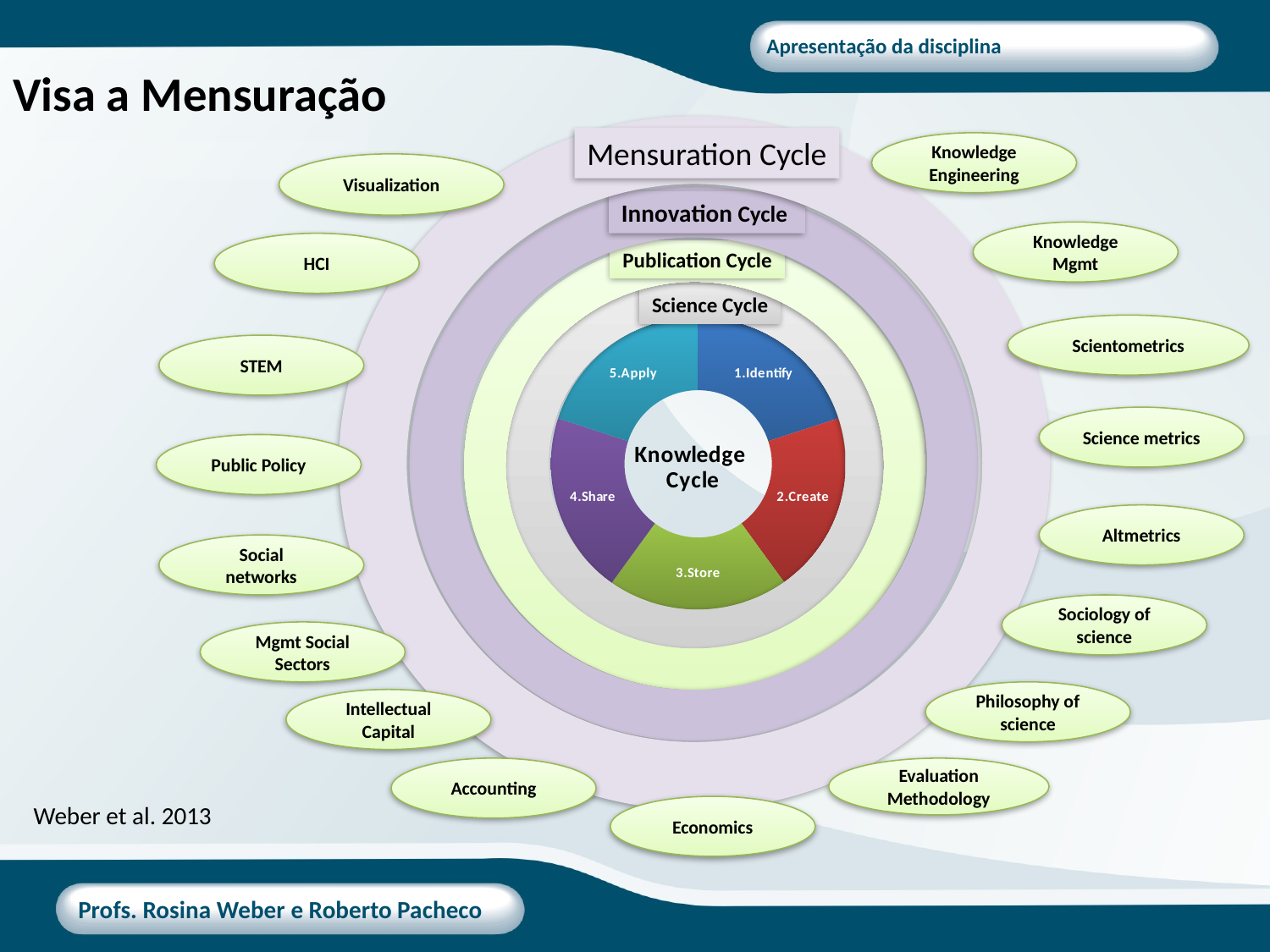
What colour is the 2.Create segment of the Knowledge Cycle? Red Which segment of the Knowledge Cycle is numbered 1? 1.Identify How many named cycle rings surround the Knowledge Cycle (Science, Publication, Innovation, Mensuration)? 4 How many segments does the Knowledge Cycle ring in the centre of the diagram have? 5 Which segment of the Knowledge Cycle is numbered 3? 3.Store What label is written in the centre of the circular diagram? Knowledge Cycle